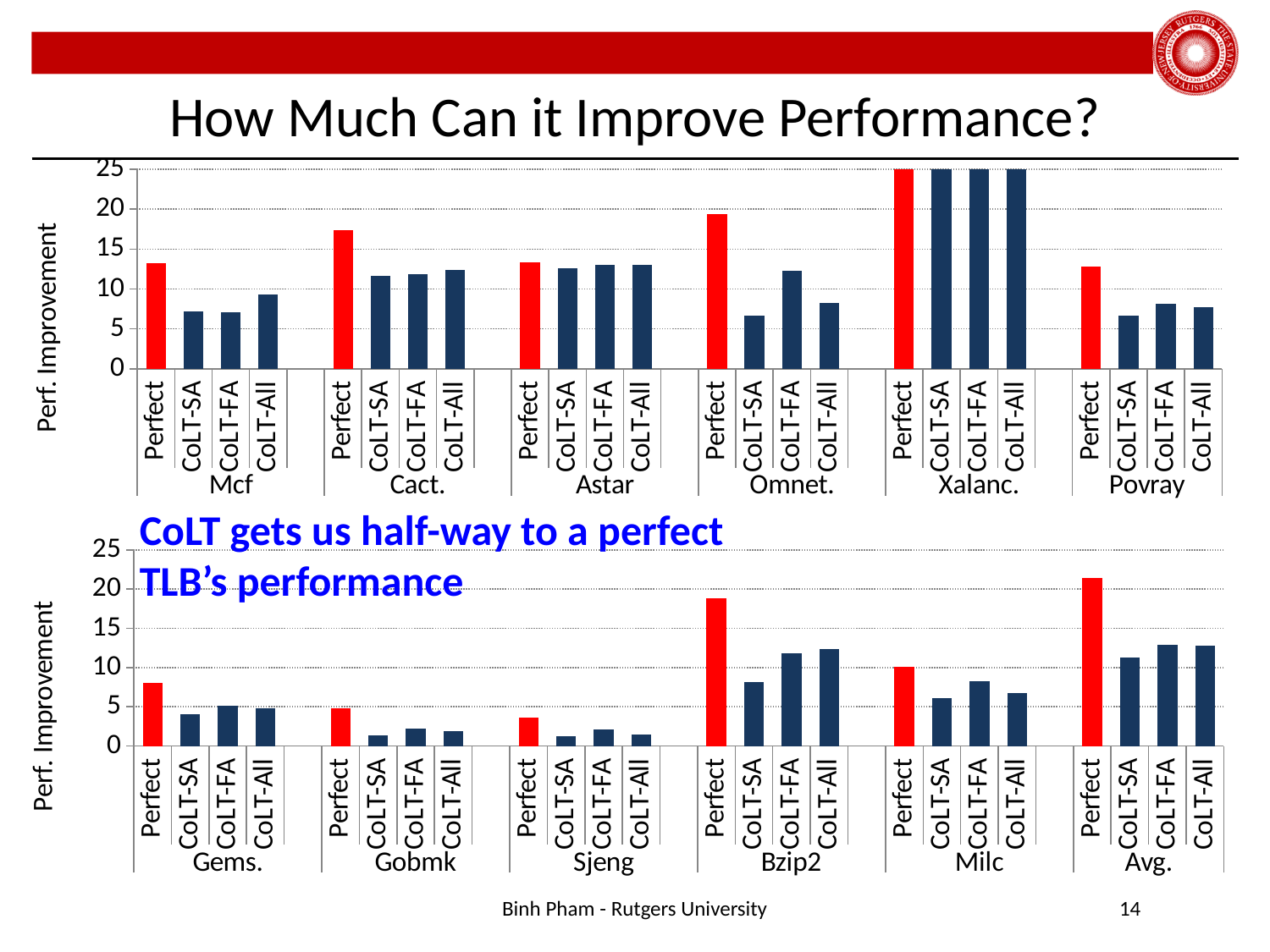
In the top chart, how many benchmark groups are shown along the x axis? 6 In the top chart, which is larger: the Perfect value for Cact. or the Perfect value for Mcf? Cact. What kind of chart is the top chart on the slide? bar chart What is the y-axis label of the bottom chart? Perf. Improvement In the bottom chart, is the Perfect value for Bzip2 greater or less than 15? greater In the bottom chart, which is larger for Milc: the Perfect value or the CoLT-FA value? Perfect In the bottom chart, which benchmark has the lowest Perfect bar? Sjeng In the top chart, is the CoLT-SA value for Mcf greater or less than 10? less In the top chart, is the Perfect value for Omnet. greater or less than 15? greater In the top chart, which benchmark has the highest Perfect bar? Xalanc. In the bottom chart, how many bars are plotted for each benchmark group? 4 In the bottom chart, which benchmark group has the highest Perfect bar? Avg.